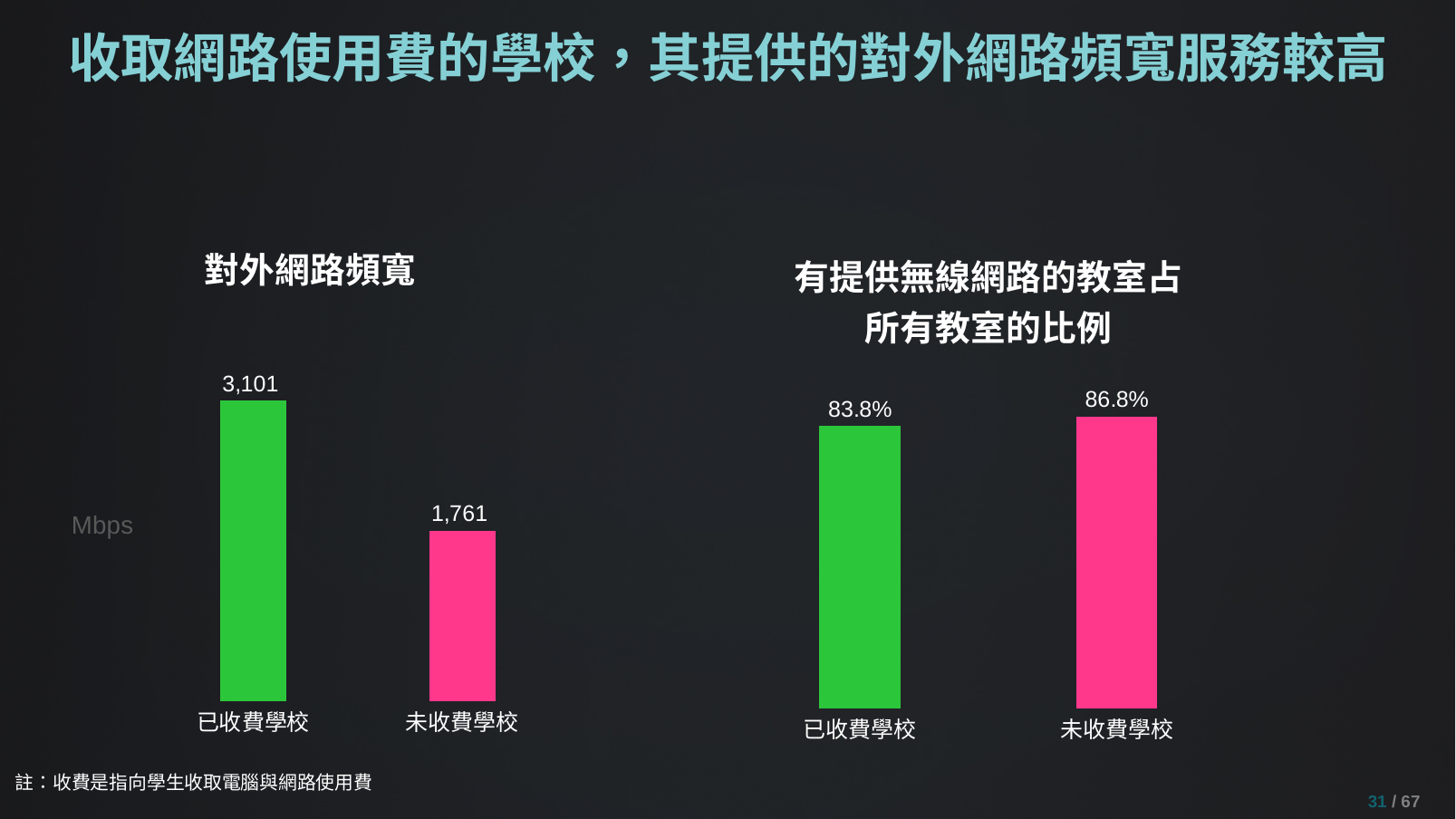
In the 有提供無線網路的教室占所有教室的比例 chart, is the value for 未收費學校 larger or smaller than the value for 已收費學校? larger In the 有提供無線網路的教室占所有教室的比例 chart, what is the value for 已收費學校? 83.8% In the 有提供無線網路的教室占所有教室的比例 chart, what is the value for 未收費學校? 86.8% In the 有提供無線網路的教室占所有教室的比例 chart, what is the difference between 未收費學校 and 已收費學校? 3.0% In the 對外網路頻寬 chart, what is the difference between 已收費學校 and 未收費學校? 1,340 In the 對外網路頻寬 chart, what is the value for 未收費學校? 1,761 What type of chart is the 有提供無線網路的教室占所有教室的比例 chart? bar chart In the 對外網路頻寬 chart, what is the value for 已收費學校? 3,101 In the 對外網路頻寬 chart, what unit is shown on the axis label? Mbps In the 有提供無線網路的教室占所有教室的比例 chart, which category has the lower value? 已收費學校 In the 對外網路頻寬 chart, which category has the higher value? 已收費學校 How many categories are shown in the 對外網路頻寬 chart? 2